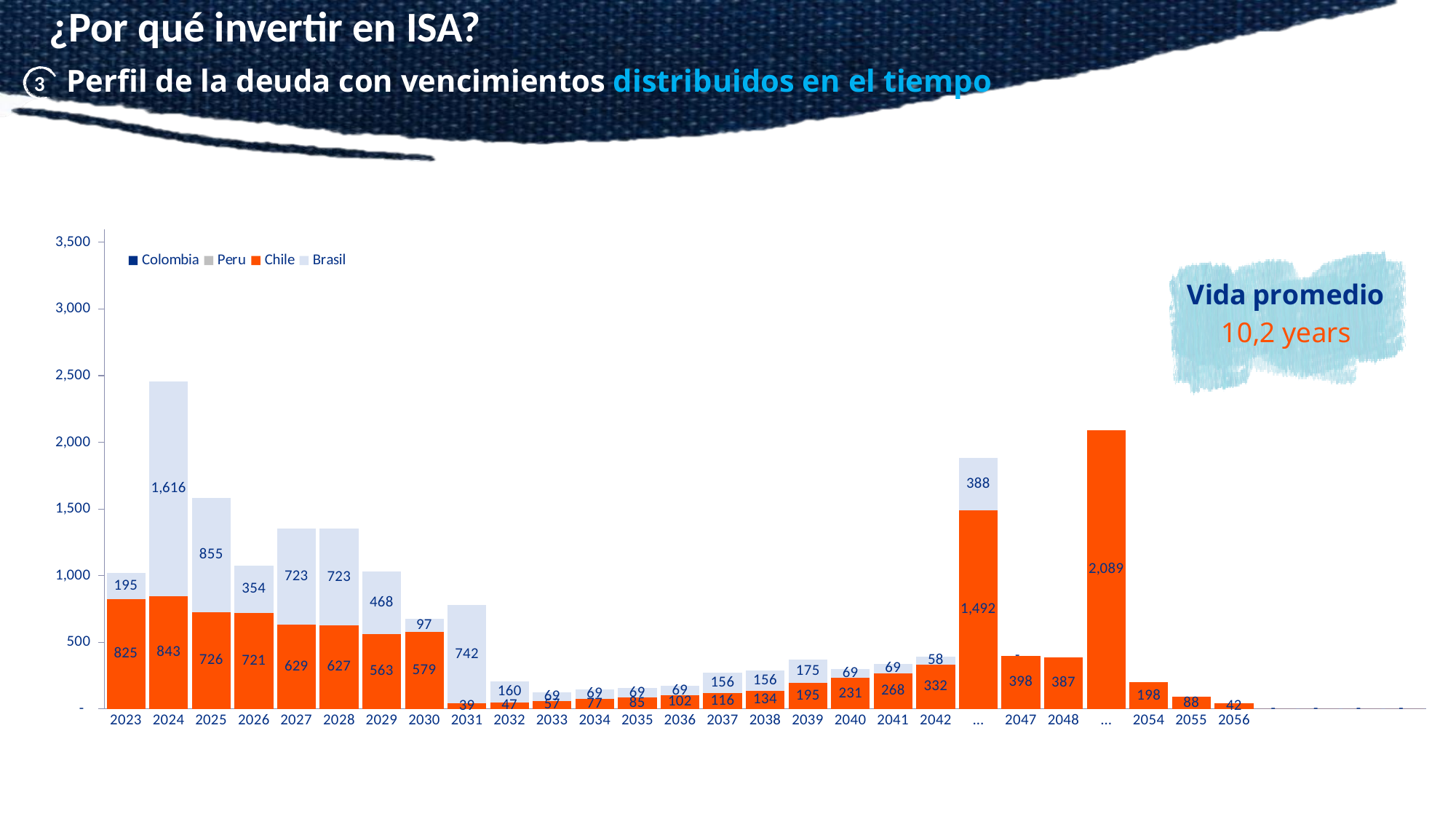
What is the total of the stacked bar for 2023? 1,020 What is the largest value labeled on an orange (Chile) segment in the chart? 2,089 What kind of chart is shown on the slide? stacked bar chart What is the difference between the light blue (Brasil) values for 2031 and 2030? 645 What is the value of the orange (Chile) segment for 2023? 825 What is the total of the stacked bar for 2024? 2,459 What average life (Vida promedio) is stated on the slide? 10,2 years How many series does the chart legend list? 4 In which year is the light blue (Brasil) segment the largest? 2024 What is the value of the light blue (Brasil) segment for 2024? 1,616 Which year has the larger orange (Chile) value, 2047 or 2048? 2047 Is the total stacked value for 2024 greater or less than 2,000? greater